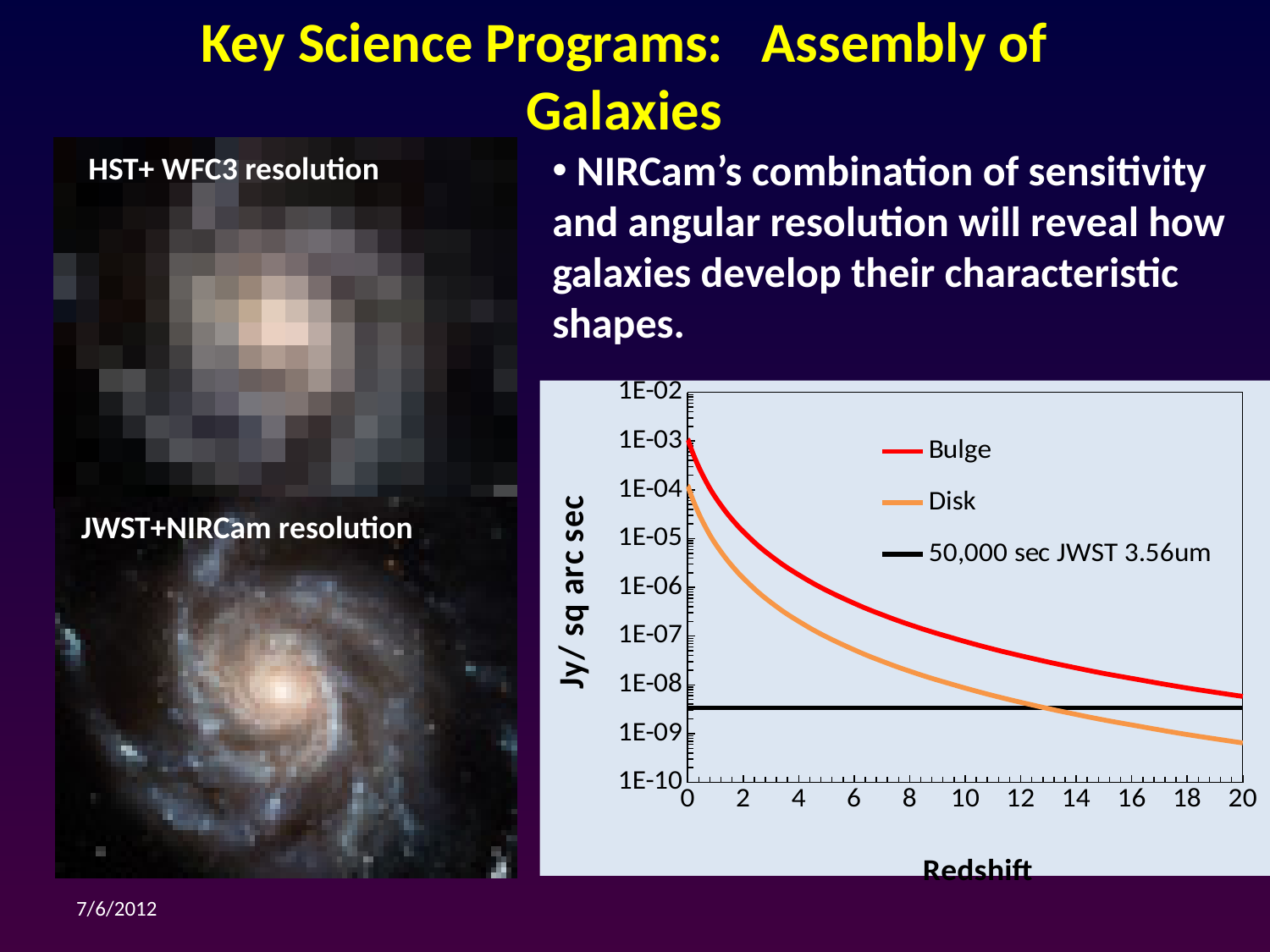
Which series is lowest at redshift 20? Disk At redshift 10, which is larger, the Bulge value or the Disk value? Bulge Is the Bulge value at redshift 20 greater or less than 1E-06? less What colour is the Bulge line in the chart? red Is the value of the 50,000 sec JWST 3.56um line greater or less than 1E-08? less Is the Disk value at redshift 20 greater or less than 1E-07? less What is the label of the chart's y axis? Jy/ sq arc sec What kind of chart is shown on the slide? line chart How many series does the chart's legend list? 3 Which series is highest at redshift 5? Bulge Does the Bulge value rise or fall as redshift increases? fall